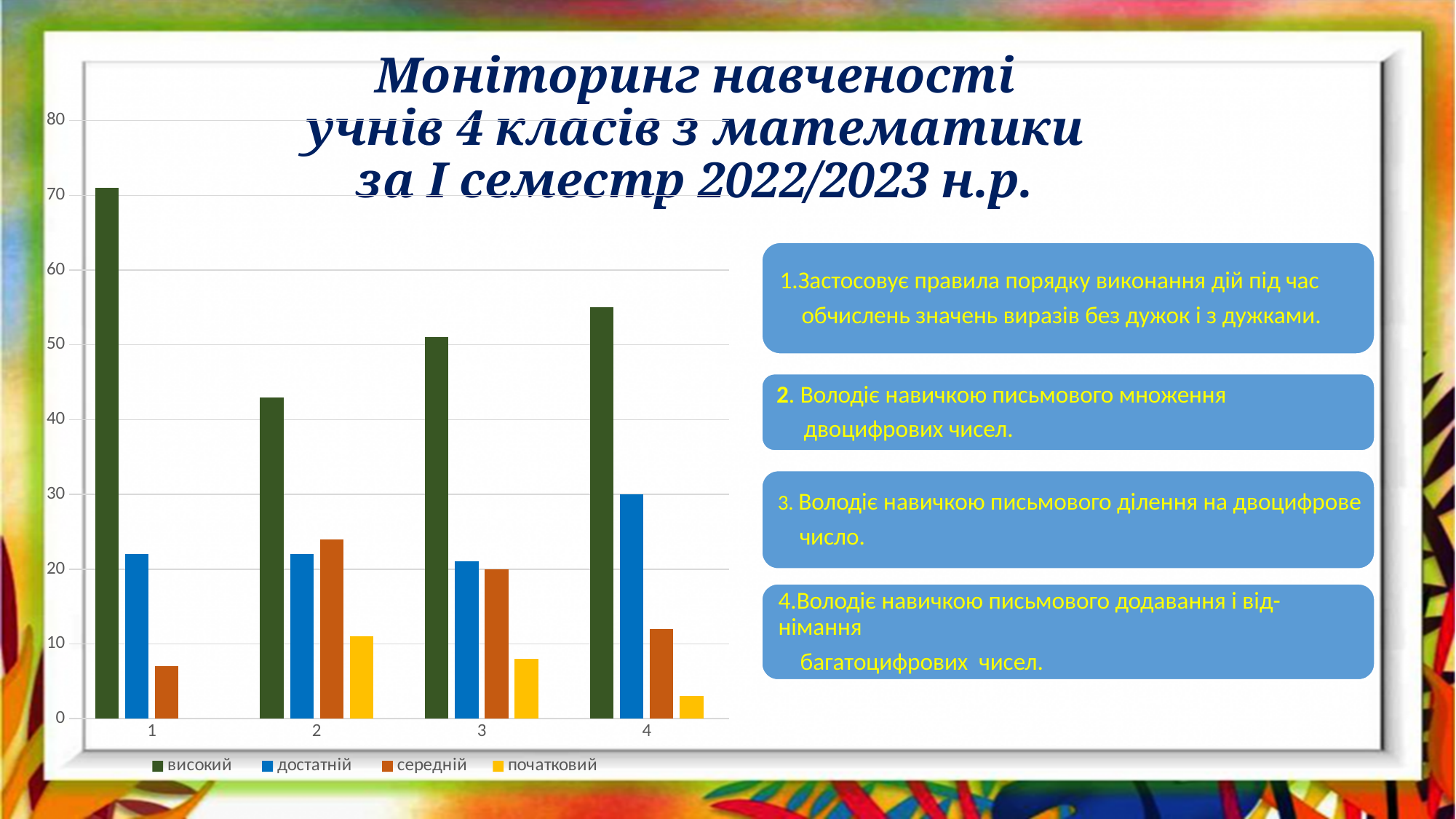
How many categories are shown on the x axis of the chart? 4 What kind of chart is shown on the slide? bar chart Is the value for високий in category 2 greater or less than 50? less Which category has the highest value for the series достатній? 4 Which is larger in category 2: the value for достатній or the value for середній? середній Is the value for початковий in category 4 greater or less than 10? less Which category has the highest value for the series високий? 1 Which category has the lowest value for the series високий? 2 Which category has the highest value for the series середній? 2 Which series is shown in yellow in the chart legend? початковий How many series does the chart legend list? 4